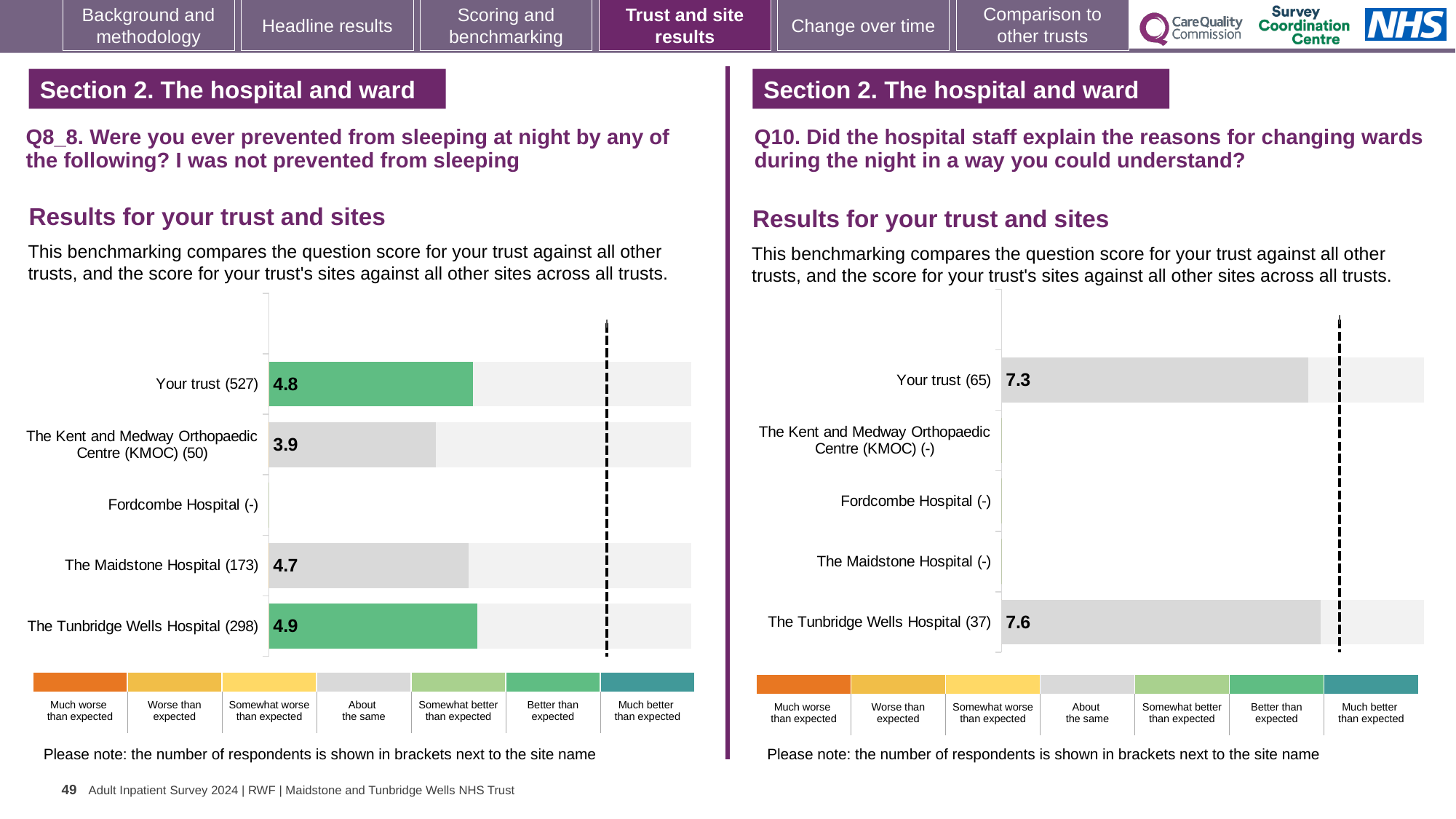
On the Q10 chart (right), what is the score for Your trust? 7.3 On the Q10 chart (right), what is the score for The Tunbridge Wells Hospital? 7.6 On the Q10 chart (right), how many sites have no score shown (marked with a dash)? 3 On the Q8_8 chart (left), what is the score for The Maidstone Hospital? 4.7 On the Q8_8 chart (left), how many respondents are shown for The Tunbridge Wells Hospital? 298 On the Q8_8 chart (left), which site has the highest score? The Tunbridge Wells Hospital On the Q10 chart (right), which is larger, the score for Your trust or for The Tunbridge Wells Hospital? The Tunbridge Wells Hospital On the Q8_8 chart (left), what is the score for Your trust? 4.8 On the Q8_8 chart (left), which site has the lowest score? The Kent and Medway Orthopaedic Centre (KMOC) On the Q8_8 chart (left), what is the difference between the scores for The Tunbridge Wells Hospital and The Kent and Medway Orthopaedic Centre (KMOC)? 1.0 On the Q8_8 chart (left), what is the score for The Kent and Medway Orthopaedic Centre (KMOC)? 3.9 What kind of chart is used on the Q8_8 chart (left)? Bar chart